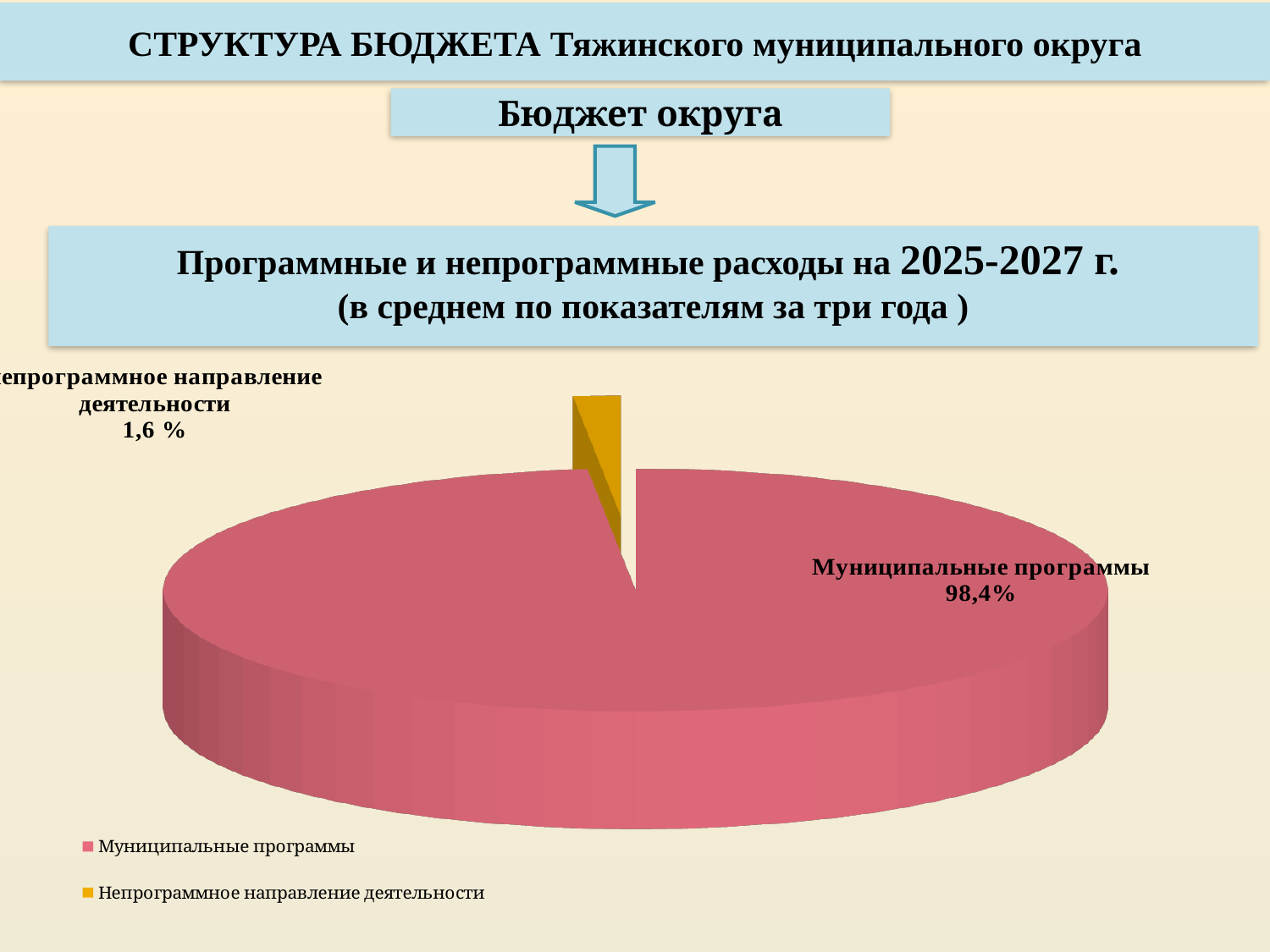
How many entries does the legend list? 2 How many slices does the pie chart have? 2 Which slice of the pie is the largest? Муниципальные программы What share of the pie does "Непрограммное направление деятельности" have? 1,6 % What colour is the "Непрограммное направление деятельности" slice? Yellow (gold) What kind of chart is shown on the slide? Pie chart Which is larger: the share of "Муниципальные программы" or the share of "Непрограммное направление деятельности"? Муниципальные программы What is the difference in percentage points between "Муниципальные программы" and "Непрограммное направление деятельности"? 96,8 Which slice of the pie is the smallest? Непрограммное направление деятельности What share of the pie does "Муниципальные программы" have? 98,4% What period does the chart heading say the expenditures refer to? 2025-2027 г.